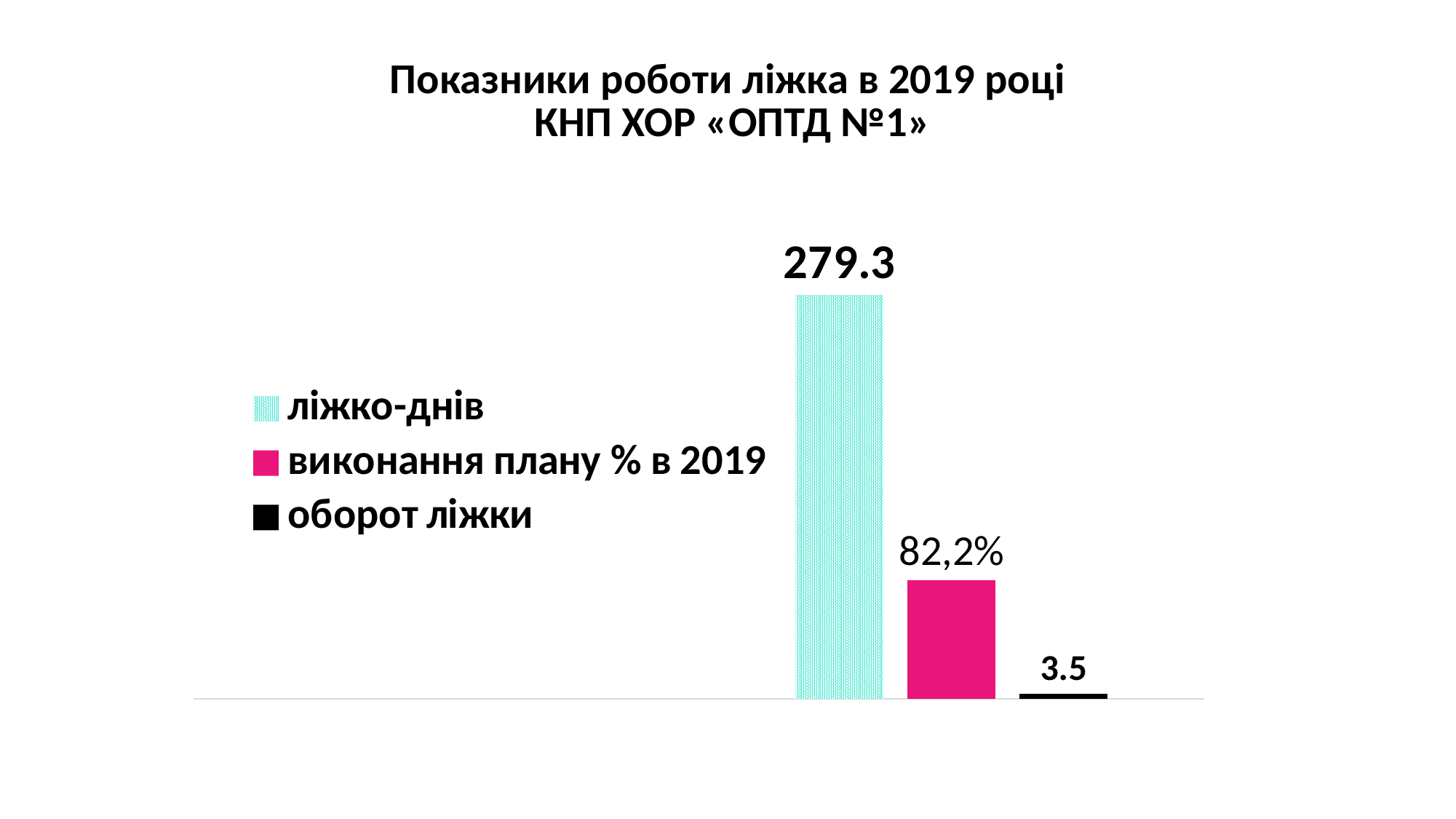
Which is larger, the value for ліжко-днів or the value for оборот ліжки? ліжко-днів What is the title of the chart? Показники роботи ліжка в 2019 році КНП ХОР «ОПТД №1» What is the value for виконання плану % в 2019? 82,2% What colour is the bar for виконання плану % в 2019? pink What is the value for оборот ліжки? 3.5 Which series has the highest value? ліжко-днів Which series has the lowest value? оборот ліжки What is the value for ліжко-днів? 279.3 How many series does the legend list? 3 What is the difference between the value for ліжко-днів and the value for оборот ліжки? 275.8 How many bars are plotted on the chart? 3 What kind of chart is shown on the slide? bar chart